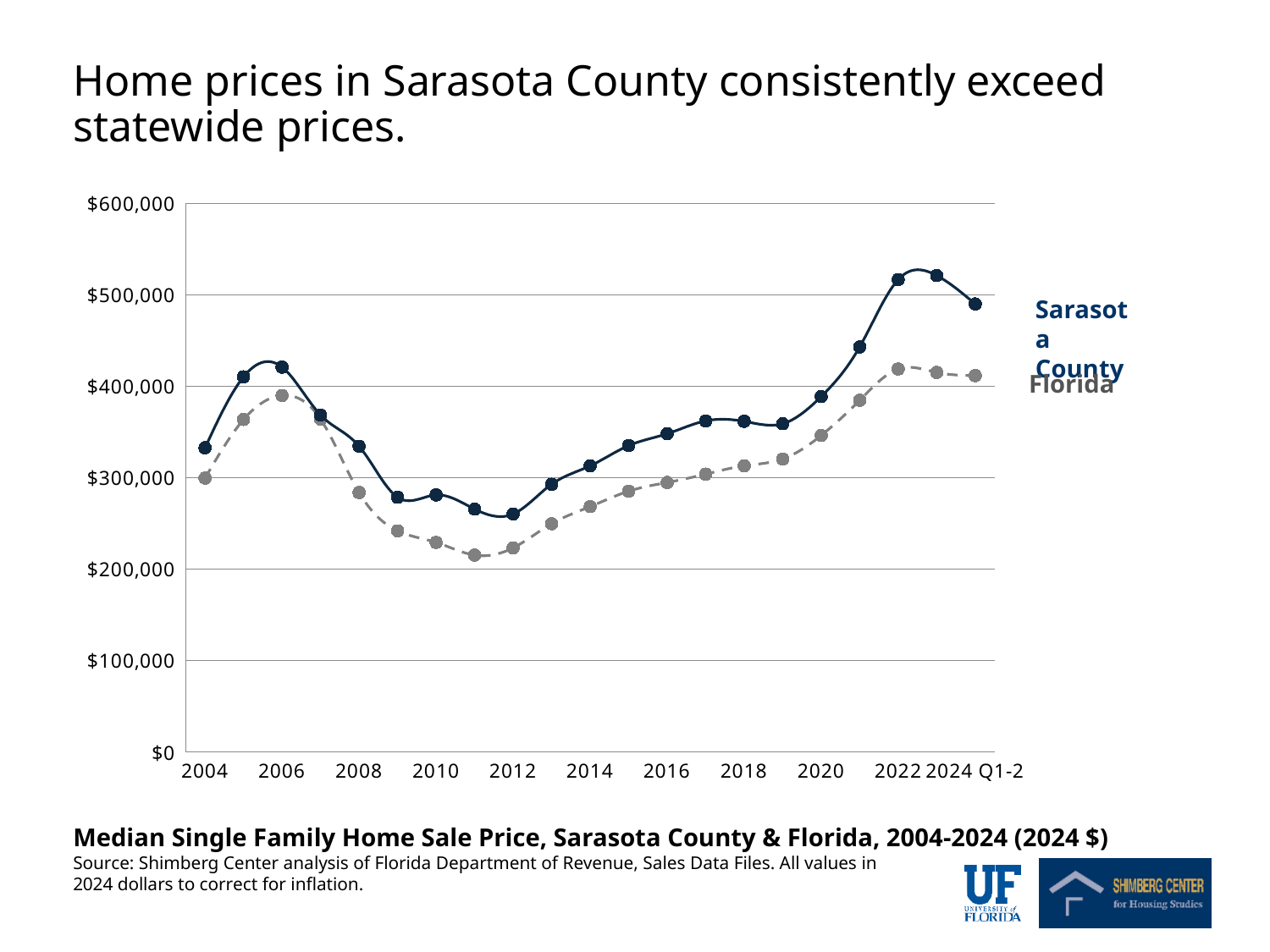
How many series does the chart plot? 2 What kind of chart is shown on the slide? line chart Is the Florida value for 2011 greater or less than $250,000? less Which two series are plotted on the chart? Sarasota County and Florida What is the title of the chart? Median Single Family Home Sale Price, Sarasota County & Florida, 2004-2024 (2024 $) Is the Florida value for 2022 greater or less than $400,000? greater Do Sarasota County prices rise or fall between 2012 and 2022? rise Is the Sarasota County value for 2022 greater or less than $500,000? greater Do Florida prices rise or fall between 2006 and 2011? fall How many data points does each series have on the chart? 21 In 2020, which series has the higher value, Sarasota County or Florida? Sarasota County